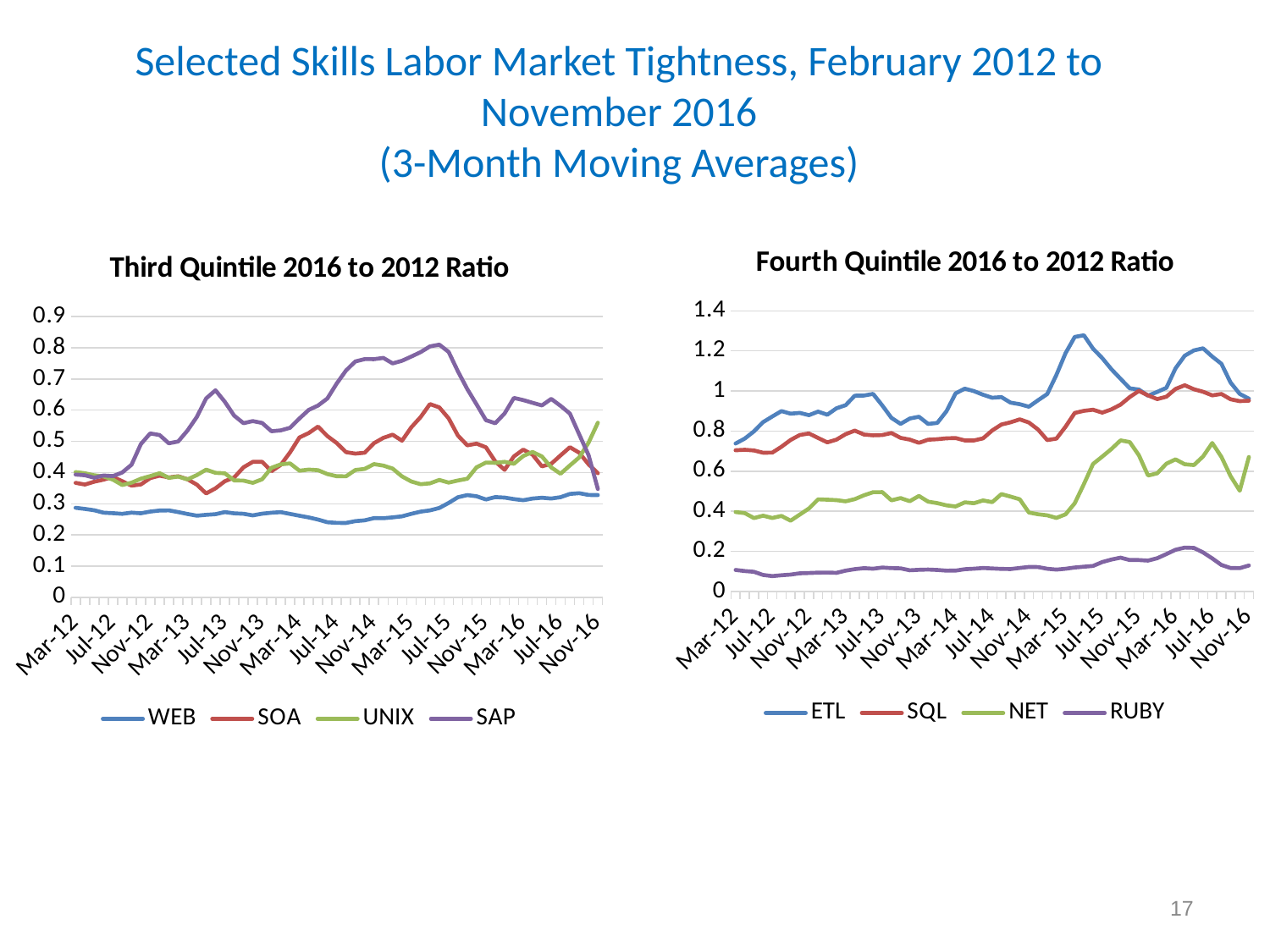
In the 'Fourth Quintile 2016 to 2012 Ratio' chart, does the SQL series rise or fall overall from Mar-12 to Nov-16? rise In the 'Third Quintile 2016 to 2012 Ratio' chart, which series has the lowest values over most of the period? WEB In the 'Third Quintile 2016 to 2012 Ratio' chart, which is larger at Mar-15, SAP or WEB? SAP How many series does the legend of the 'Fourth Quintile 2016 to 2012 Ratio' chart list? 4 In the 'Third Quintile 2016 to 2012 Ratio' chart, which series reaches the highest value? SAP In the 'Fourth Quintile 2016 to 2012 Ratio' chart, which is larger at Mar-13, SQL or NET? SQL In the 'Fourth Quintile 2016 to 2012 Ratio' chart, which series has the lowest values throughout the period? RUBY In the 'Fourth Quintile 2016 to 2012 Ratio' chart, is the value for ETL at Jul-15 greater or less than 1.2? less In the 'Third Quintile 2016 to 2012 Ratio' chart, is the value for WEB at Jul-14 greater or less than 0.3? less Which series are listed in the legend of the 'Third Quintile 2016 to 2012 Ratio' chart? WEB, SOA, UNIX, SAP What kind of chart is the 'Third Quintile 2016 to 2012 Ratio' chart? line chart In the 'Third Quintile 2016 to 2012 Ratio' chart, is the value for SAP at Jul-15 greater or less than 0.7? greater